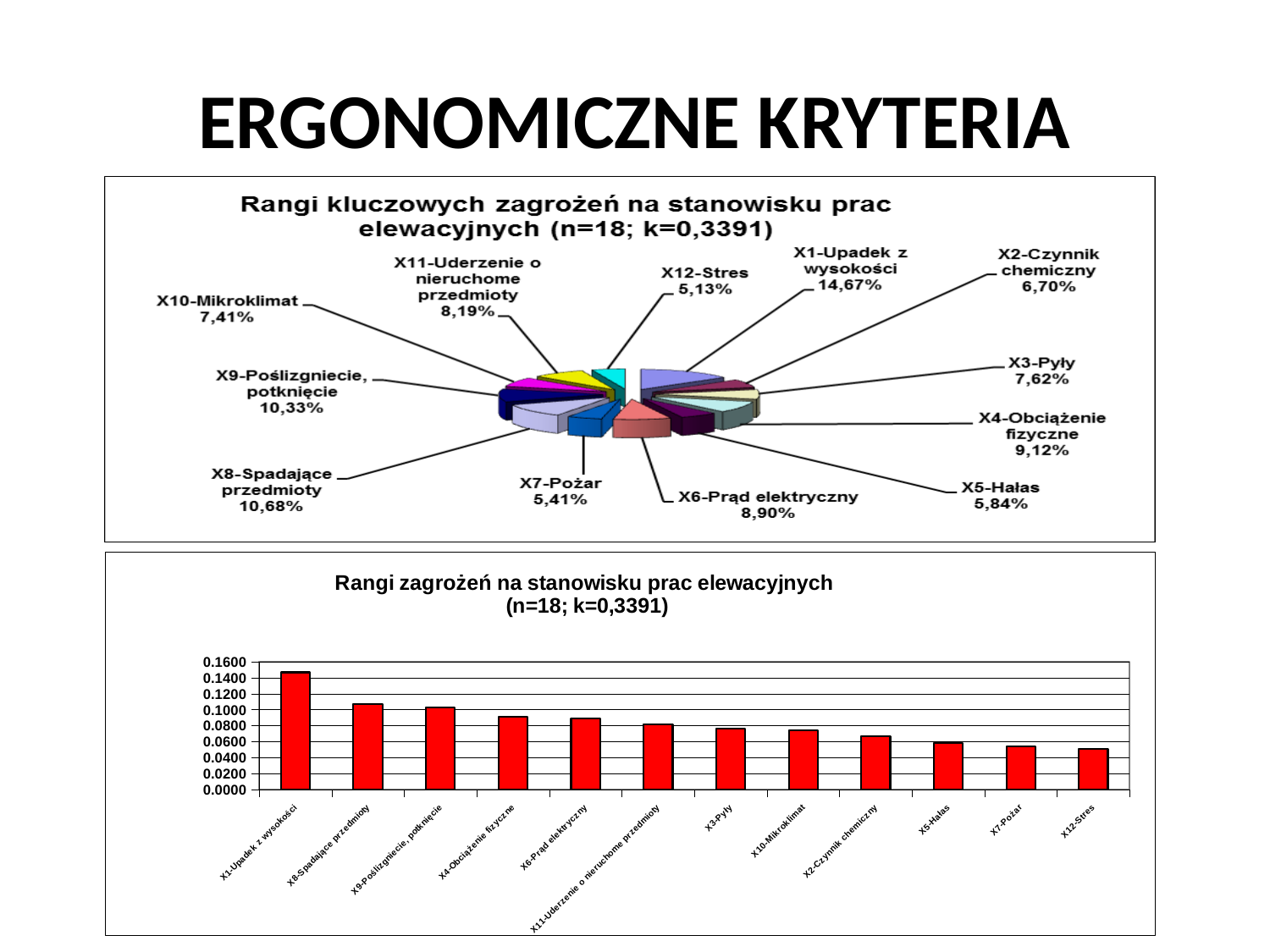
In the pie chart at the top of the slide, what is the difference between the shares of X8-Spadające przedmioty and X7-Pożar? 5,27% How many categories does the pie chart at the top of the slide show? 12 What type of chart is the chart at the bottom of the slide? bar chart In the bar chart at the bottom of the slide, is the value for X1-Upadek z wysokości greater or less than 0.1400? greater In the pie chart at the top of the slide, which category has the smallest share? X12-Stres In the pie chart at the top of the slide, what is the share for X1-Upadek z wysokości? 14,67% In the bar chart at the bottom of the slide, do the values rise or fall from left to right along the x axis? fall What is the title of the chart at the bottom of the slide? Rangi zagrożeń na stanowisku prac elewacyjnych (n=18; k=0,3391) In the pie chart at the top of the slide, which has a larger share: X4-Obciążenie fizyczne or X6-Prąd elektryczny? X4-Obciążenie fizyczne In the pie chart at the top of the slide, what is the share for X9-Poślizgniecie, potknięcie? 10,33% In the pie chart at the top of the slide, which category has the largest share? X1-Upadek z wysokości In the bar chart at the bottom of the slide, is the value for X7-Pożar greater or less than 0.0600? less